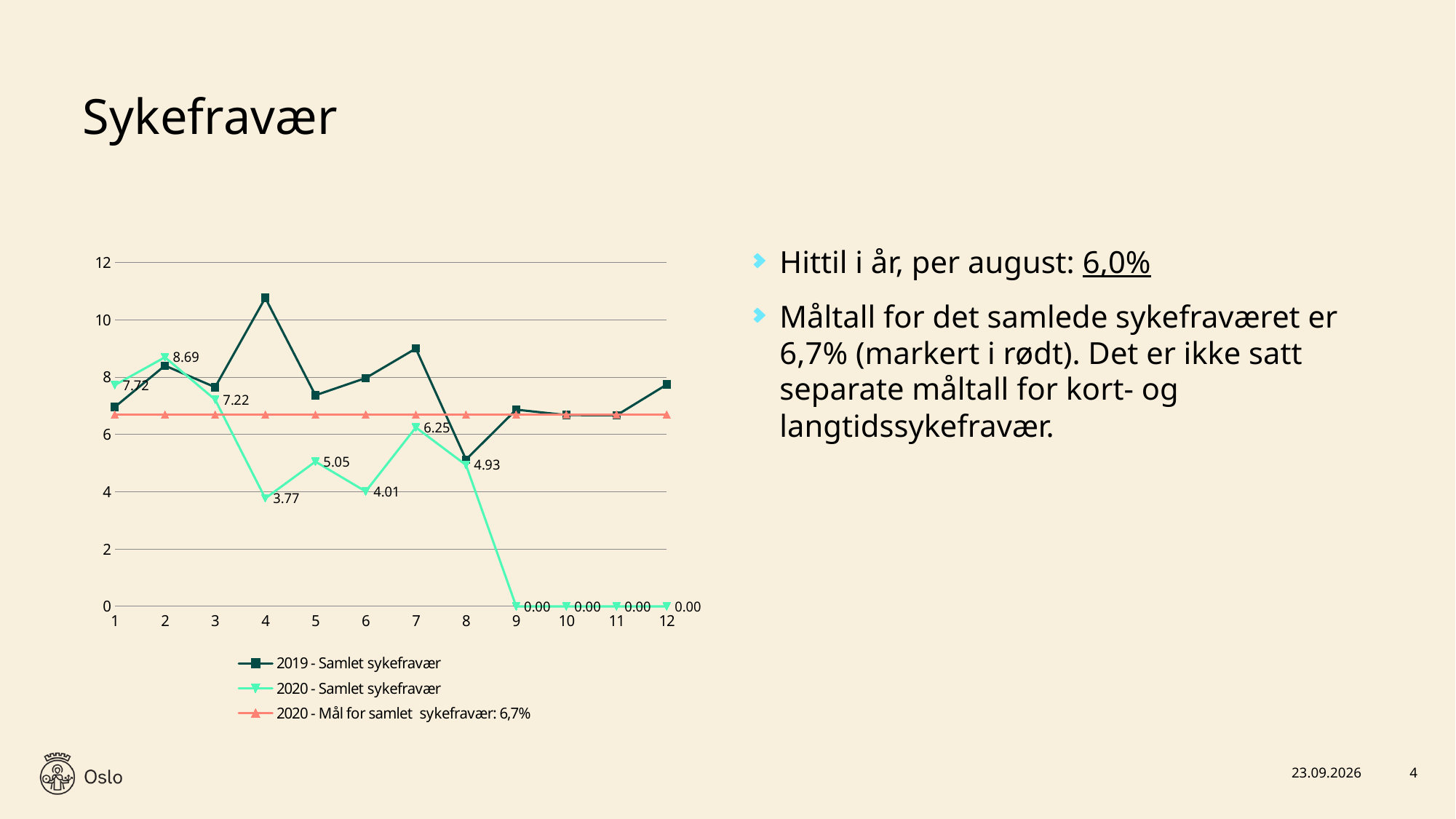
What is the difference between the 2020 - Samlet sykefravær values at month 2 and month 1? 0.97 Which is larger for the 2020 - Samlet sykefravær series: the value at month 5 or at month 6? month 5 Is the value of the 2019 - Samlet sykefravær series at month 4 greater or less than 10? greater Is the value of the 2019 - Samlet sykefravær series at month 8 greater or less than 6? less How many series does the chart legend list? 3 What is the value of the 2020 - Samlet sykefravær series at month 2? 8.69 How many months are shown on the x axis of the chart? 12 What is the value of the 2020 - Samlet sykefravær series at month 7? 6.25 What is the value of the 2020 - Samlet sykefravær series at month 4? 3.77 At which month does the 2020 - Samlet sykefravær series reach its highest value? 2 What is the difference between the 2020 - Samlet sykefravær values at month 7 and month 8? 1.32 What type of chart is shown on the slide? line chart